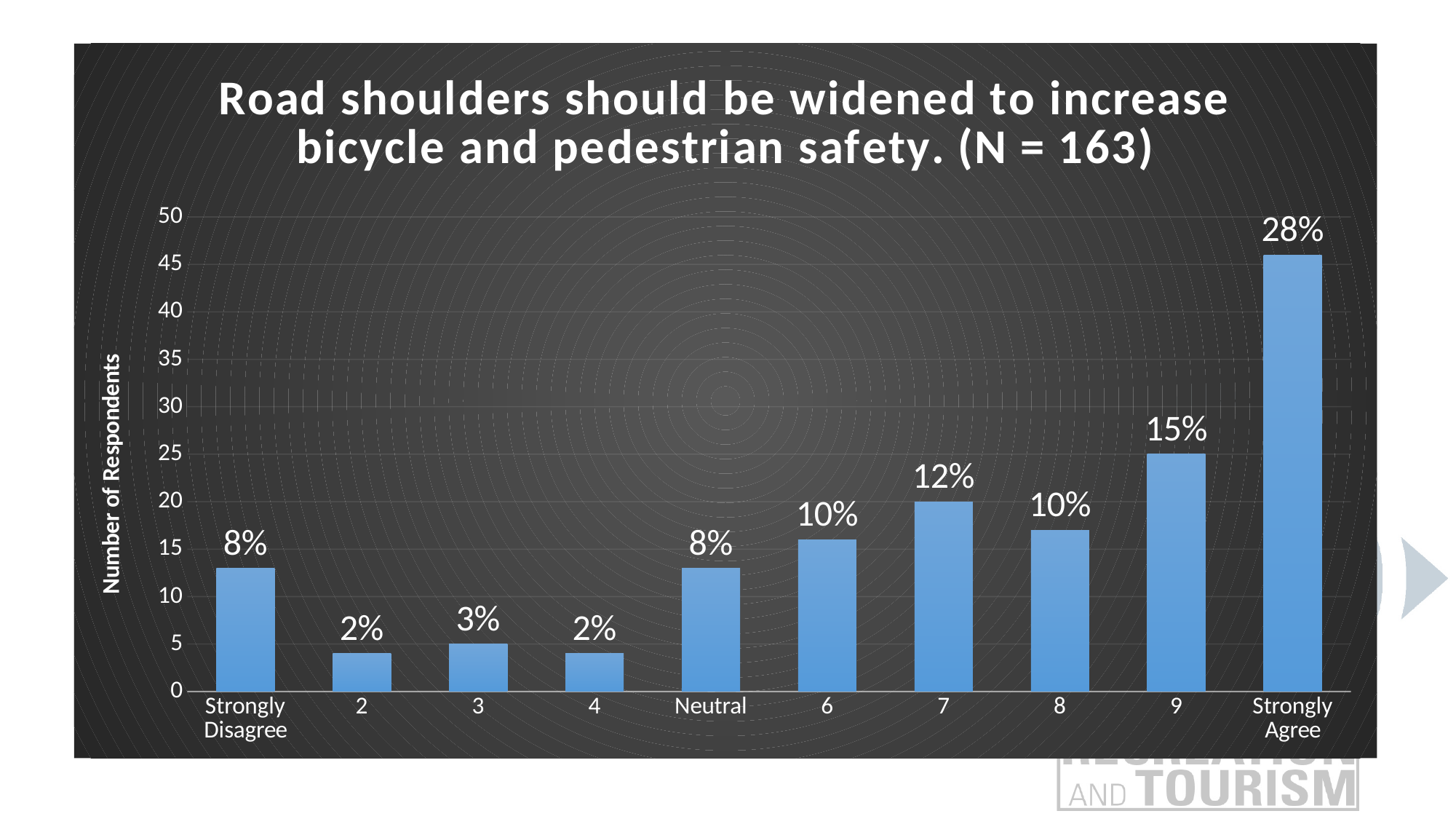
What percentage label is shown for the bar labelled 9? 15% Is the number of respondents for Strongly Agree greater or less than 40? greater What percentage label is shown for the Neutral bar? 8% Is the number of respondents for Strongly Disagree greater or less than 15? less What type of chart is shown on the slide? bar chart Which category has the highest bar? Strongly Agree How many categories are shown on the x axis? 10 What percentage label is shown for the Strongly Agree bar? 28% What percentage label is shown for the bar labelled 3? 3% What is the label of the vertical axis? Number of Respondents Which bar is taller, the one labelled 7 or the one labelled 8? 7 What is the difference in percentage points between the Strongly Agree label and the bar labelled 9? 13%